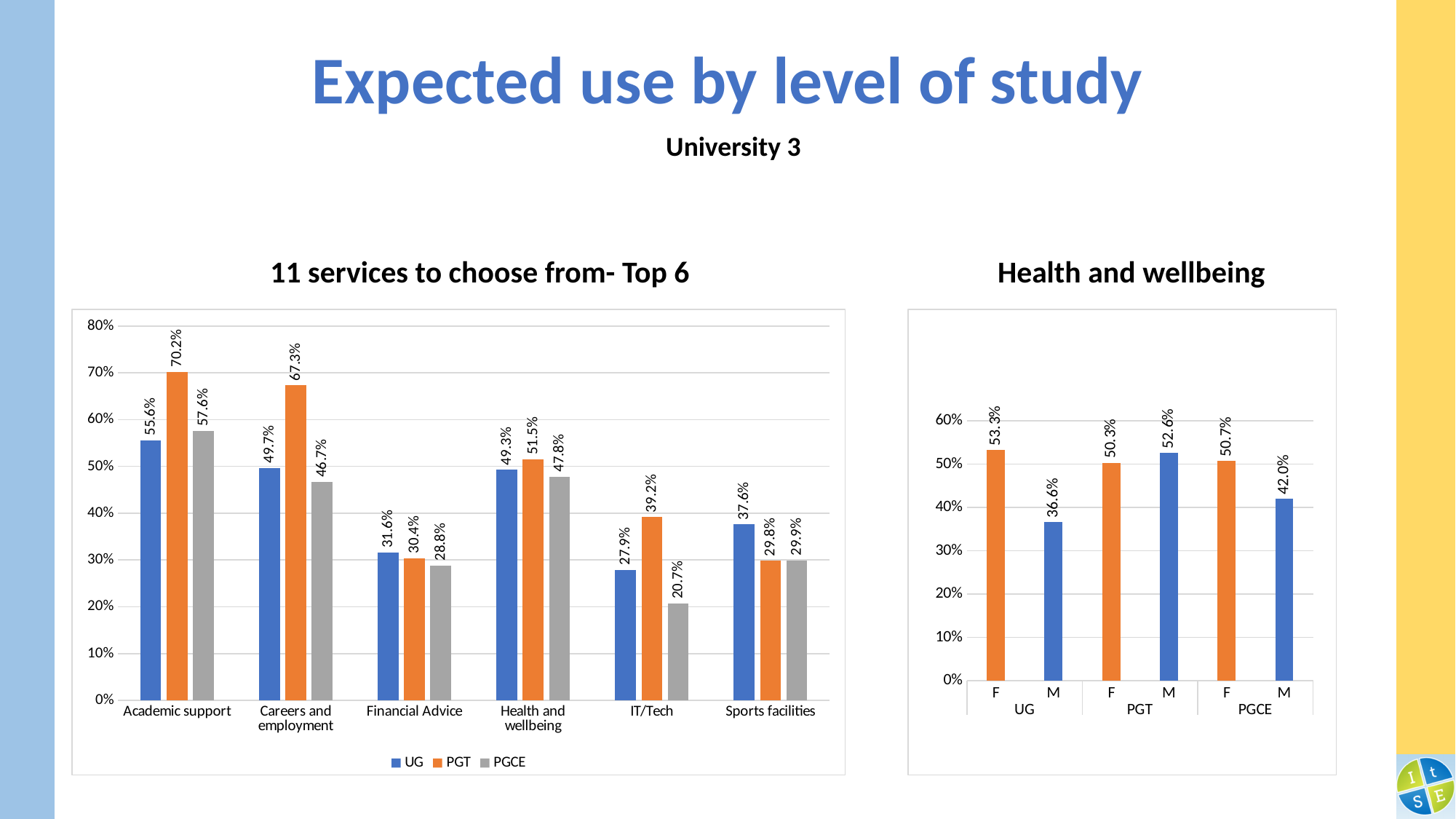
What kind of chart is the 'Health and wellbeing' chart? bar chart In the 'Health and wellbeing' chart, what is the difference between the F and M values in the UG group? 16.7% In the '11 services to choose from- Top 6' chart, which service has the lowest PGCE value? IT/Tech In the '11 services to choose from- Top 6' chart, what is the difference between the PGT and UG values for Careers and employment? 17.6% In the 'Health and wellbeing' chart, which bar has the lowest value? UG M How many series does the legend of the '11 services to choose from- Top 6' chart list? 3 In the '11 services to choose from- Top 6' chart, which is larger for Financial Advice: the UG value or the PGT value? UG How many service categories are shown in the '11 services to choose from- Top 6' chart? 6 In the '11 services to choose from- Top 6' chart, what is the PGCE value for IT/Tech? 20.7% In the '11 services to choose from- Top 6' chart, what is the PGT value for Academic support? 70.2% In the 'Health and wellbeing' chart, what is the value for M in the PGT group? 52.6% In the '11 services to choose from- Top 6' chart, which service has the highest UG value? Academic support